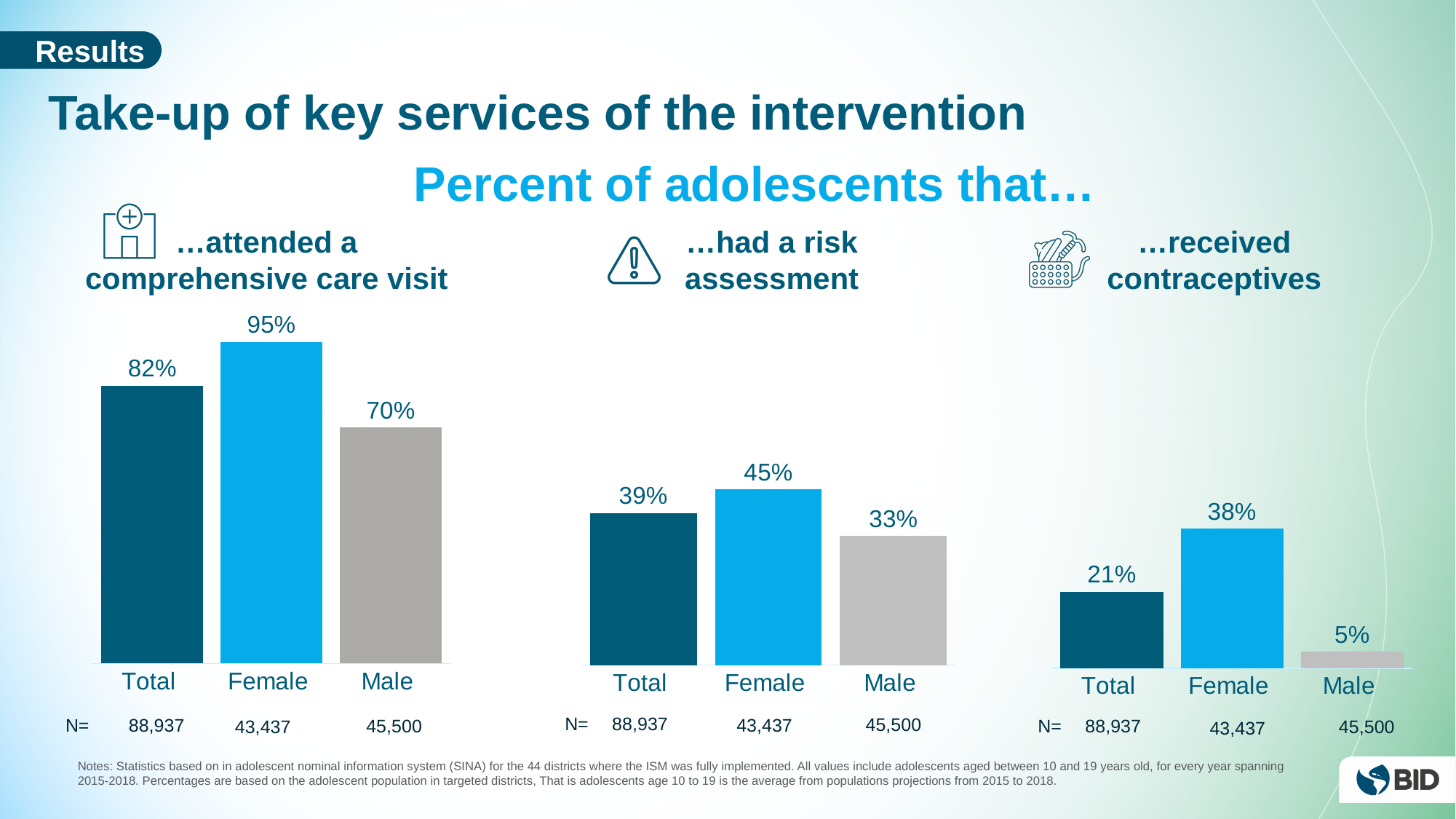
In the '…received contraceptives' chart, which category has the lowest value? Male In the '…received contraceptives' chart, what is the difference between the Female and Total values? 17% In the '…received contraceptives' chart, what is the value for Total? 21% In the '…attended a comprehensive care visit' chart, which category has the highest value? Female How many bars are in the '…had a risk assessment' chart? 3 In the '…attended a comprehensive care visit' chart, what is the N value shown for Male? 45,500 How many charts are shown on the slide? 3 In the '…had a risk assessment' chart, what is the value for Male? 33% In the '…had a risk assessment' chart, what is the difference between the Female and Male values? 12% What kind of chart is used for '…received contraceptives'? Bar chart In the '…attended a comprehensive care visit' chart, what is the value for Female? 95% In the '…attended a comprehensive care visit' chart, which is larger, the value for Total or the value for Male? Total